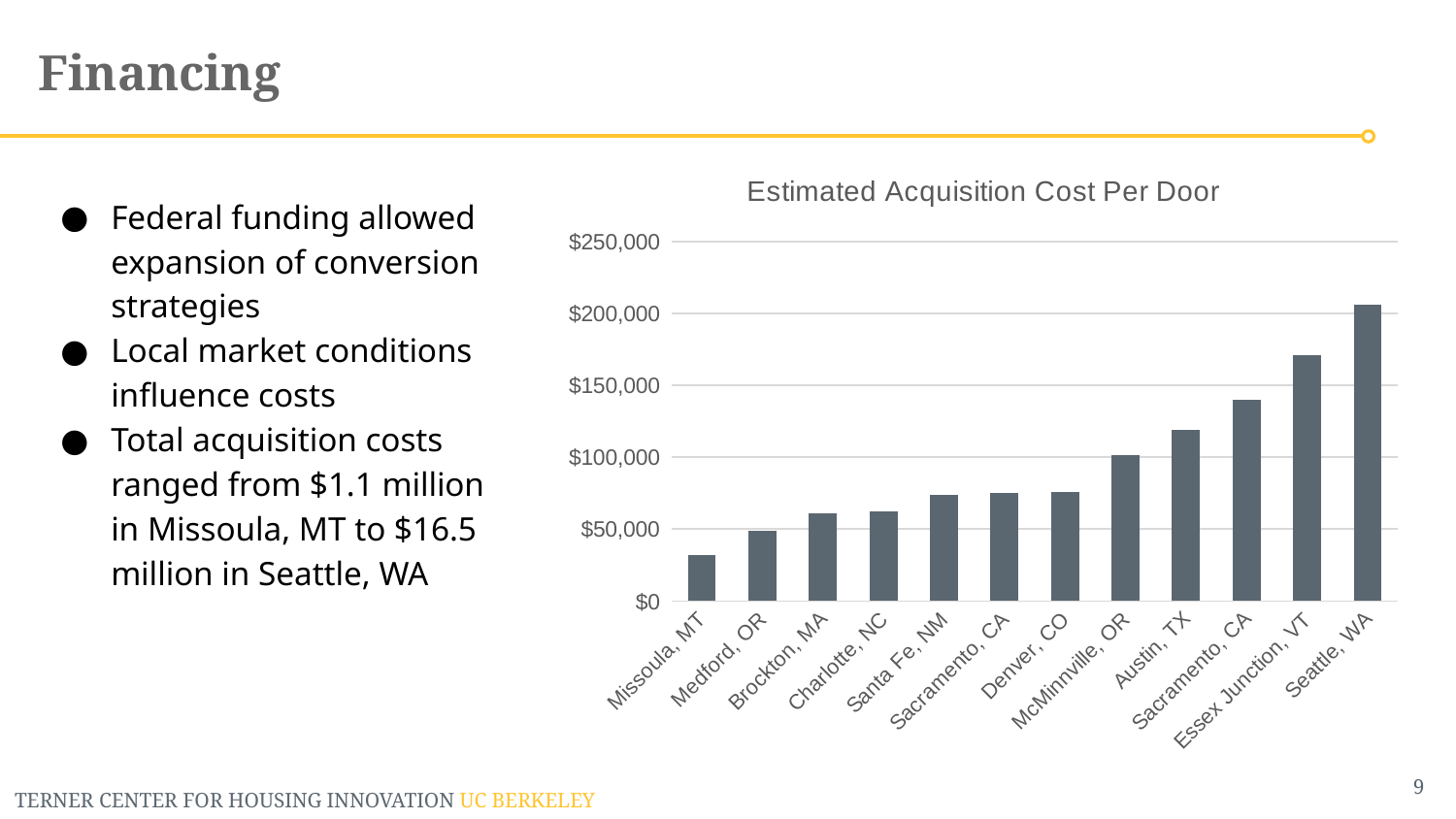
Which city has the lowest estimated acquisition cost per door? Missoula, MT Is the value for Essex Junction, VT greater or less than $150,000? greater Is the value for Seattle, WA greater or less than $200,000? greater How many cities are shown on the x axis of the chart? 12 Is the value for Denver, CO greater or less than $100,000? less What is the title of the chart? Estimated Acquisition Cost Per Door What kind of chart is shown on the slide? bar chart Which has a lower estimated acquisition cost per door, Medford, OR or Denver, CO? Medford, OR Do the values rise or fall moving from left to right along the x axis? rise Which has a higher estimated acquisition cost per door, Essex Junction, VT or Austin, TX? Essex Junction, VT Which city has the highest estimated acquisition cost per door? Seattle, WA